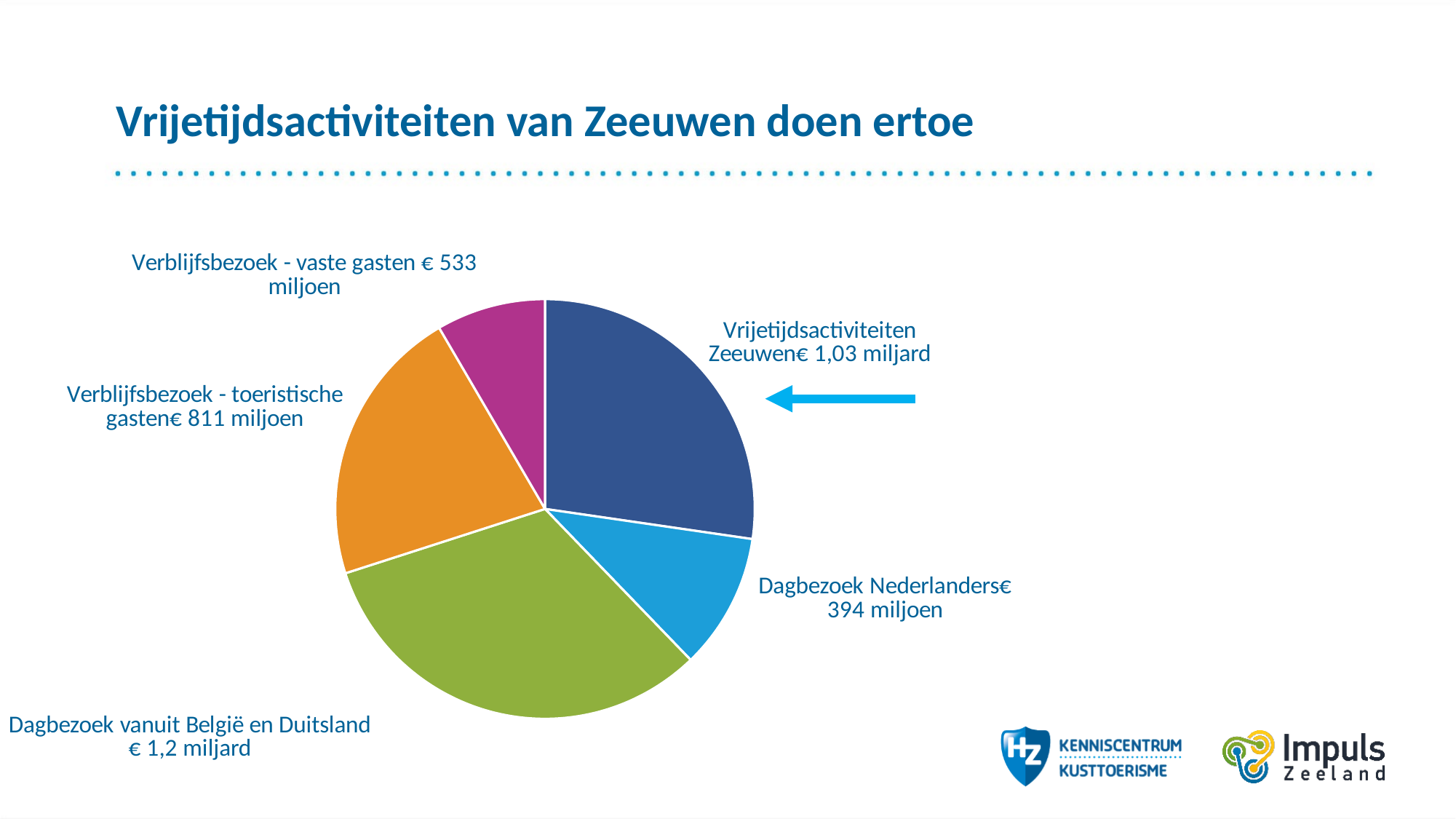
Which is larger: Verblijfsbezoek - toeristische gasten or Verblijfsbezoek - vaste gasten? Verblijfsbezoek - toeristische gasten What is the difference between Verblijfsbezoek - toeristische gasten and Verblijfsbezoek - vaste gasten? € 278 miljoen What is the value for Dagbezoek vanuit België en Duitsland? € 1,2 miljard What type of chart is shown on the slide? Pie chart How many slices does the pie chart have? 5 What is the value for Vrijetijdsactiviteiten Zeeuwen? € 1,03 miljard Which category does the arrow on the slide point to? Vrijetijdsactiviteiten Zeeuwen What is the value for Verblijfsbezoek - vaste gasten? € 533 miljoen Which category has the largest value in the pie chart? Dagbezoek vanuit België en Duitsland What is the value for Dagbezoek Nederlanders? € 394 miljoen What is the value for Verblijfsbezoek - toeristische gasten? € 811 miljoen